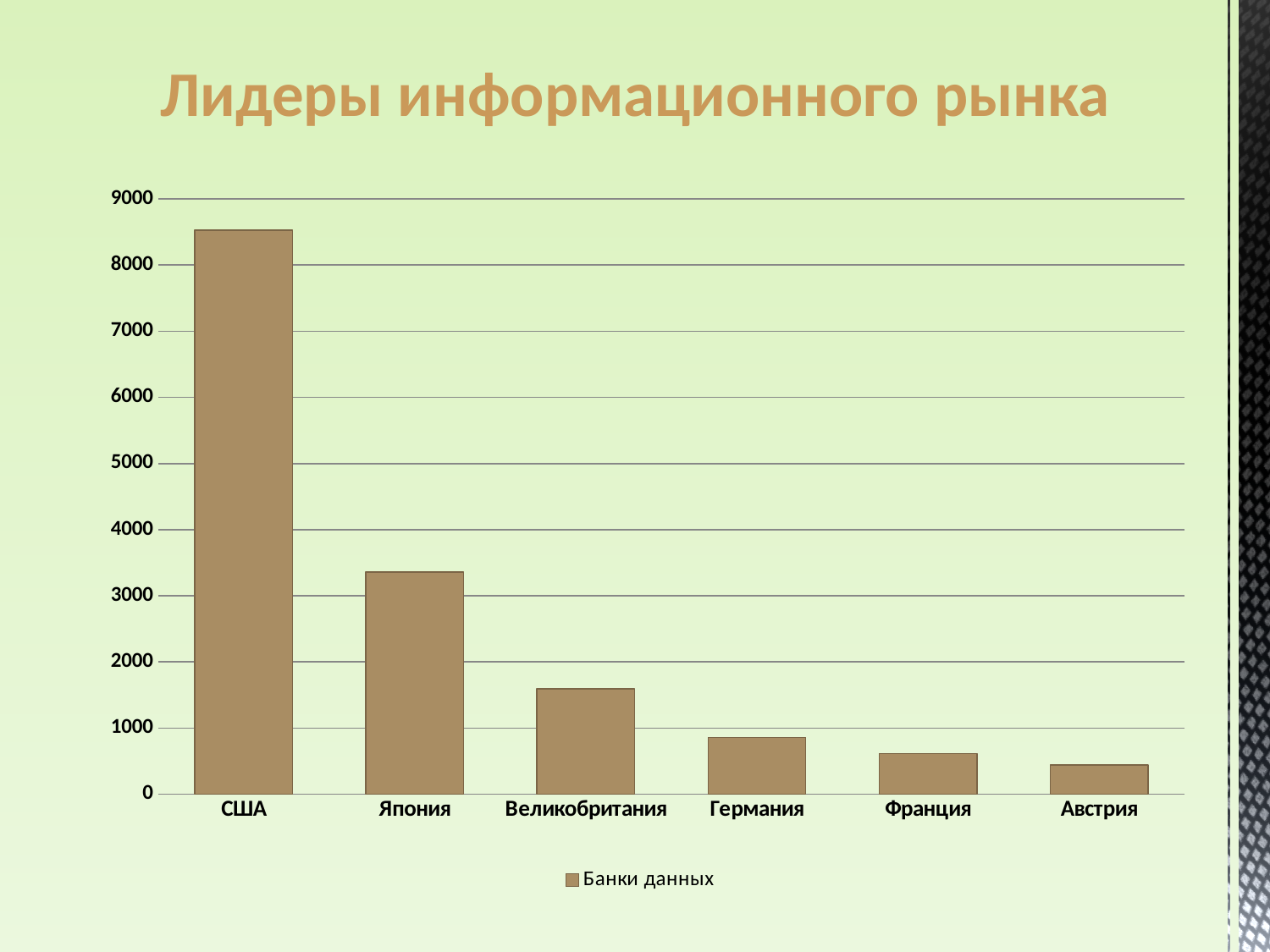
Do the values rise or fall from left to right along the x axis? Fall How many countries are shown on the x axis of the chart? 6 Which country has the highest value in the chart? США Which is larger, the value for Япония or the value for Великобритания? Япония What is the name of the series shown in the legend? Банки данных Is the value for США greater or less than 8000? greater Is the value for Германия greater or less than 1000? less What kind of chart is shown on the slide? Bar chart Is the value for Великобритания greater or less than 2000? less How many series does the legend list? 1 Which country has the lowest value in the chart? Австрия